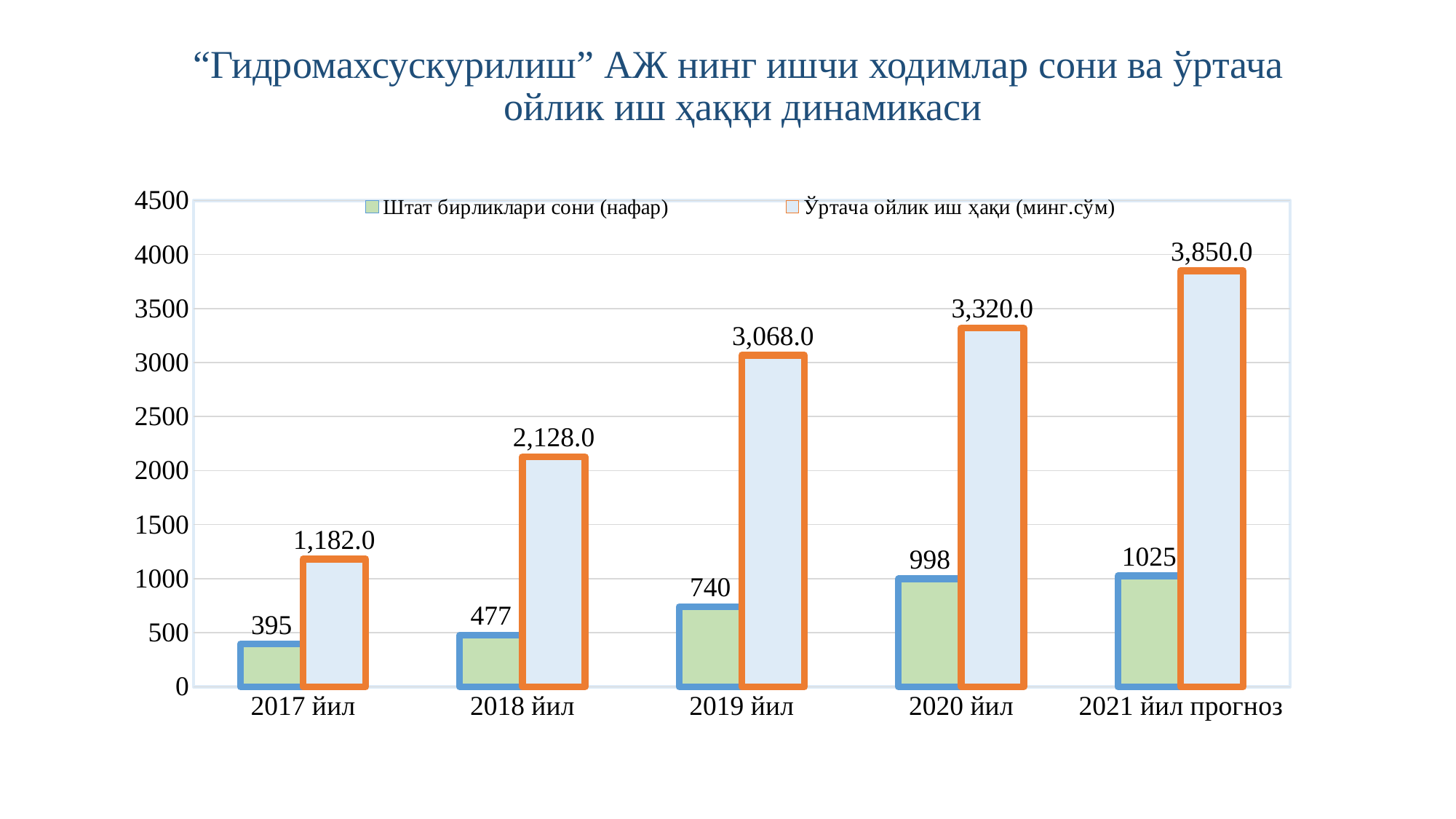
Which is larger: Штат бирликлари сони (нафар) for 2020 йил or for 2019 йил? 2020 йил What is the value of Ўртача ойлик иш ҳақи (минг.сўм) for 2021 йил прогноз? 3,850.0 Which category has the lowest value for Ўртача ойлик иш ҳақи (минг.сўм)? 2017 йил What is the value of Ўртача ойлик иш ҳақи (минг.сўм) for 2018 йил? 2,128.0 Do the values of Ўртача ойлик иш ҳақи (минг.сўм) rise or fall from 2017 йил to 2021 йил прогноз? Rise What kind of chart is shown on the slide? Bar chart What is the difference between the Ўртача ойлик иш ҳақи (минг.сўм) values for 2020 йил and 2019 йил? 252.0 How many categories are shown on the x axis? 5 What is the value of Штат бирликлари сони (нафар) for 2019 йил? 740 How many series does the legend list? 2 What is the difference between the Штат бирликлари сони (нафар) values for 2018 йил and 2017 йил? 82 Which category has the highest value for Штат бирликлари сони (нафар)? 2021 йил прогноз